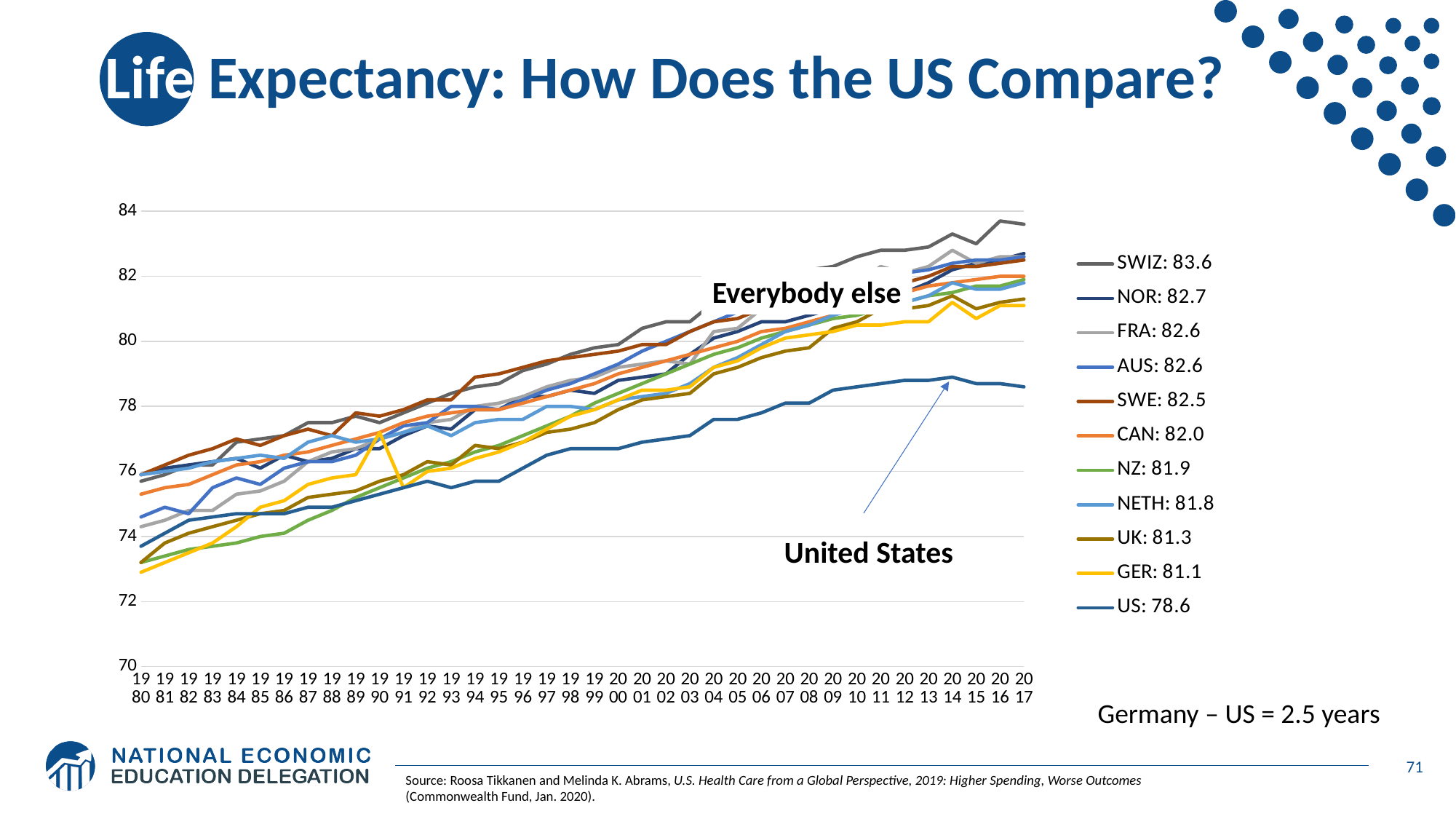
Does the US line rise or fall from 1980 to 2017? rises Which country has the lowest life expectancy value in the legend? US Which country has the highest life expectancy value in the legend? SWIZ What life expectancy value is shown for SWIZ in the legend? 83.6 What life expectancy value is shown for the US in the legend? 78.6 What is the difference between the GER value and the US value shown in the legend? 2.5 Which has the larger legend value, NOR or CAN? NOR What kind of chart is shown on the slide? line chart Is the US value in 2000 greater or less than 78? less How many series does the legend list? 11 What is the difference between the SWIZ value and the US value shown in the legend? 5.0 How many years are shown on the x axis? 38